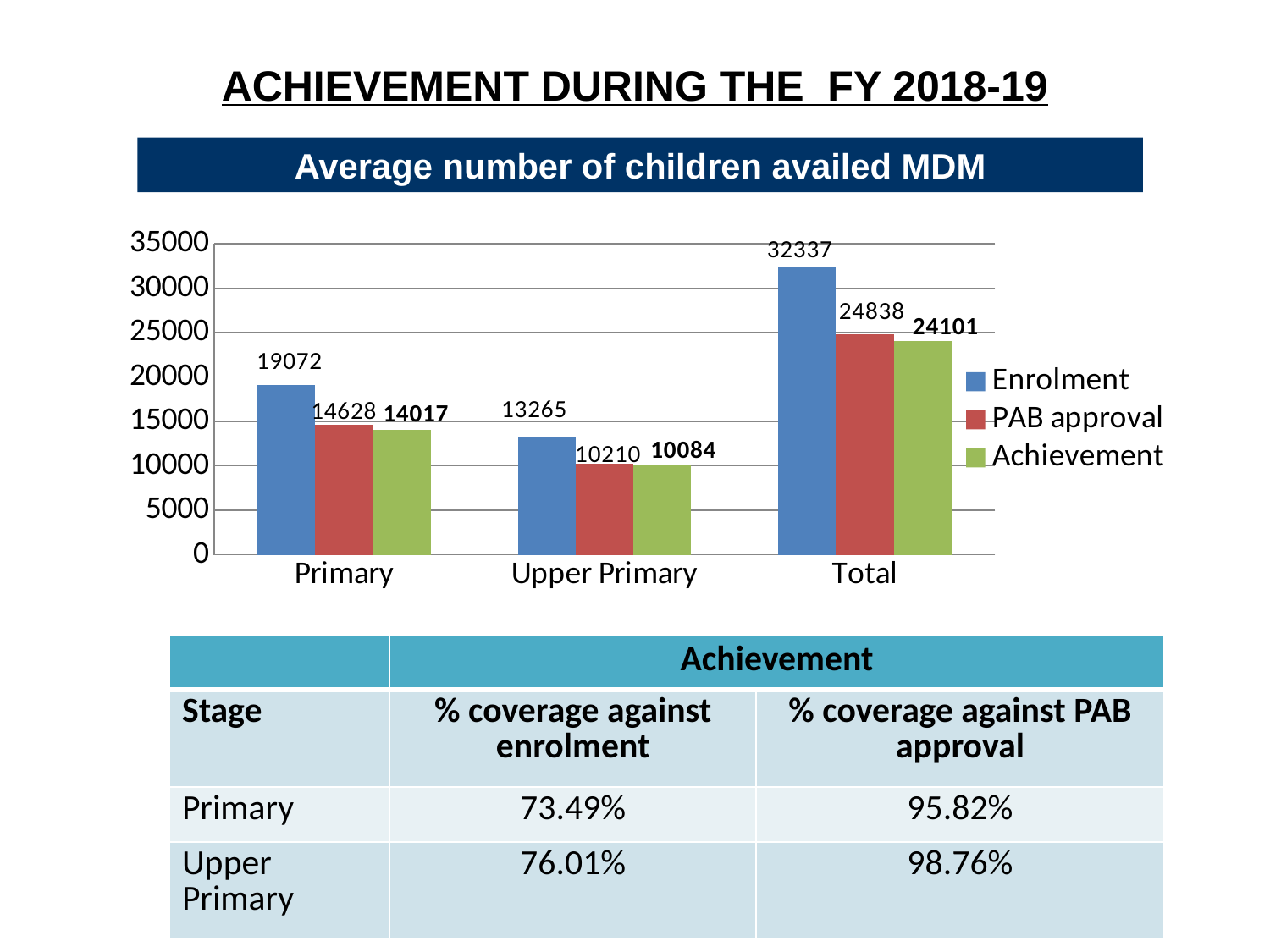
What is the Achievement value for Total? 24101 How many series does the legend list? 3 How many categories are shown on the x axis? 3 Which is larger, the Enrolment value for Upper Primary or the PAB approval value for Primary? PAB approval value for Primary What is the difference between Enrolment and Achievement for Primary? 5055 Which category has the highest Enrolment value? Total Which category has the lowest Achievement value? Upper Primary What is the title of the chart? Average number of children availed MDM What kind of chart is shown on the slide? Bar chart What is the difference between PAB approval and Achievement for Total? 737 What is the Enrolment value for Primary? 19072 What is the PAB approval value for Upper Primary? 10210